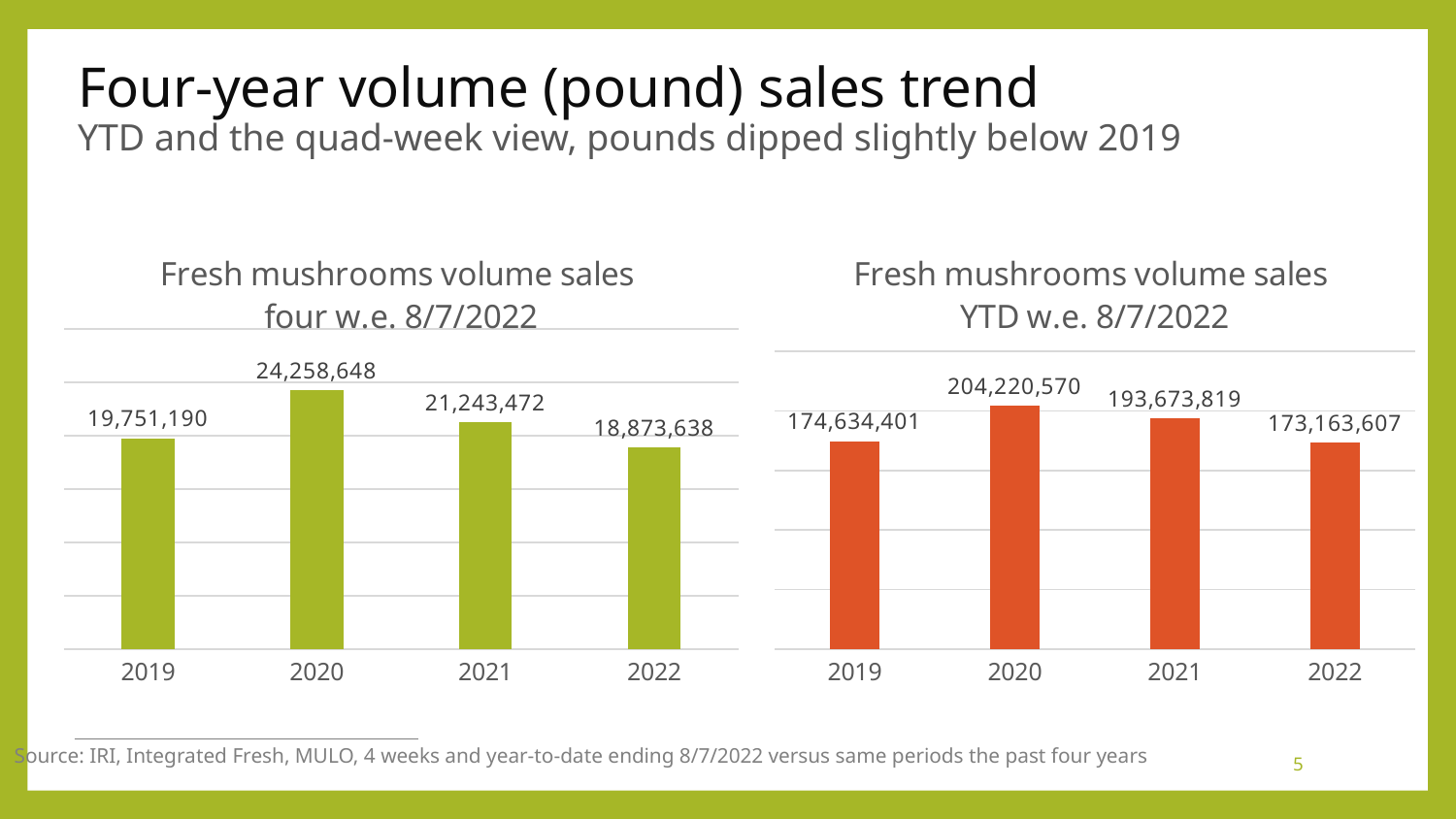
In the 'Fresh mushrooms volume sales YTD w.e. 8/7/2022' chart, which year has the highest value? 2020 In the 'Fresh mushrooms volume sales four w.e. 8/7/2022' chart, what is the value for 2020? 24,258,648 In the 'Fresh mushrooms volume sales four w.e. 8/7/2022' chart, which year has the lowest value? 2022 In the 'Fresh mushrooms volume sales YTD w.e. 8/7/2022' chart, what is the difference between the 2020 and 2021 values? 10,546,751 How many years are shown in the 'Fresh mushrooms volume sales YTD w.e. 8/7/2022' chart? 4 In the 'Fresh mushrooms volume sales four w.e. 8/7/2022' chart, what is the difference between the 2020 and 2019 values? 4,507,458 In the 'Fresh mushrooms volume sales YTD w.e. 8/7/2022' chart, what is the value for 2022? 173,163,607 In the 'Fresh mushrooms volume sales YTD w.e. 8/7/2022' chart, do the values rise or fall from 2020 to 2022? Fall What type of chart is the 'Fresh mushrooms volume sales four w.e. 8/7/2022' chart? Bar chart In the 'Fresh mushrooms volume sales four w.e. 8/7/2022' chart, which is larger, the value for 2021 or the value for 2022? 2021 What colour are the bars in the 'Fresh mushrooms volume sales YTD w.e. 8/7/2022' chart? Orange In the 'Fresh mushrooms volume sales YTD w.e. 8/7/2022' chart, which is larger, the value for 2019 or the value for 2022? 2019